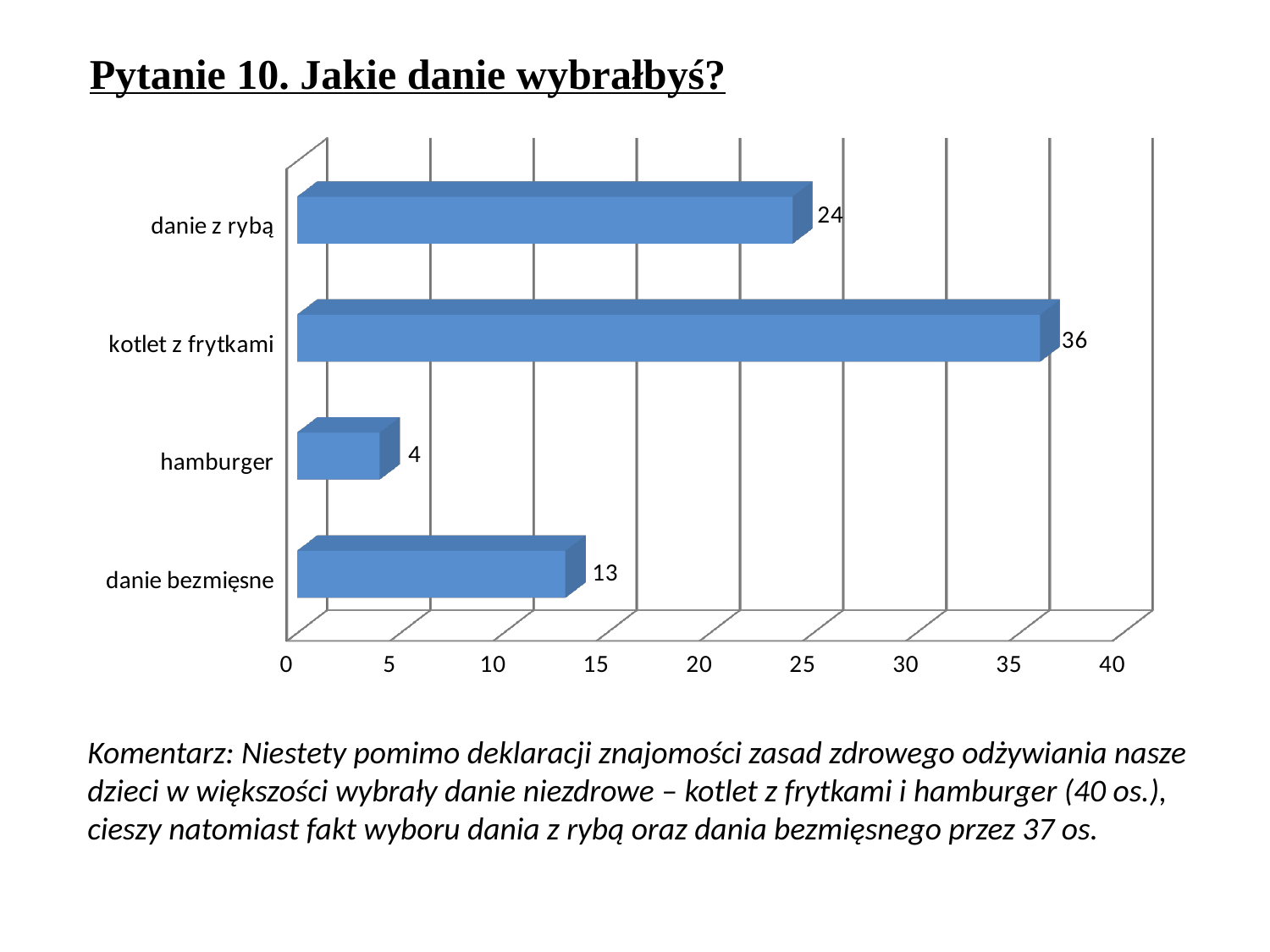
Which is larger, the value for "danie z rybą" or the value for "danie bezmięsne"? danie z rybą What is the value for "kotlet z frytkami"? 36 What is the value for "danie bezmięsne"? 13 What is the difference between the values for "kotlet z frytkami" and "danie z rybą"? 12 What is the value for "hamburger"? 4 What kind of chart is shown on the slide? bar chart What is the value for "danie z rybą"? 24 Which category has the lowest value? hamburger Which category has the highest value? kotlet z frytkami Is the value for "kotlet z frytkami" greater or less than 30? greater How many categories are shown in the chart? 4 What is the difference between the values for "danie bezmięsne" and "hamburger"? 9